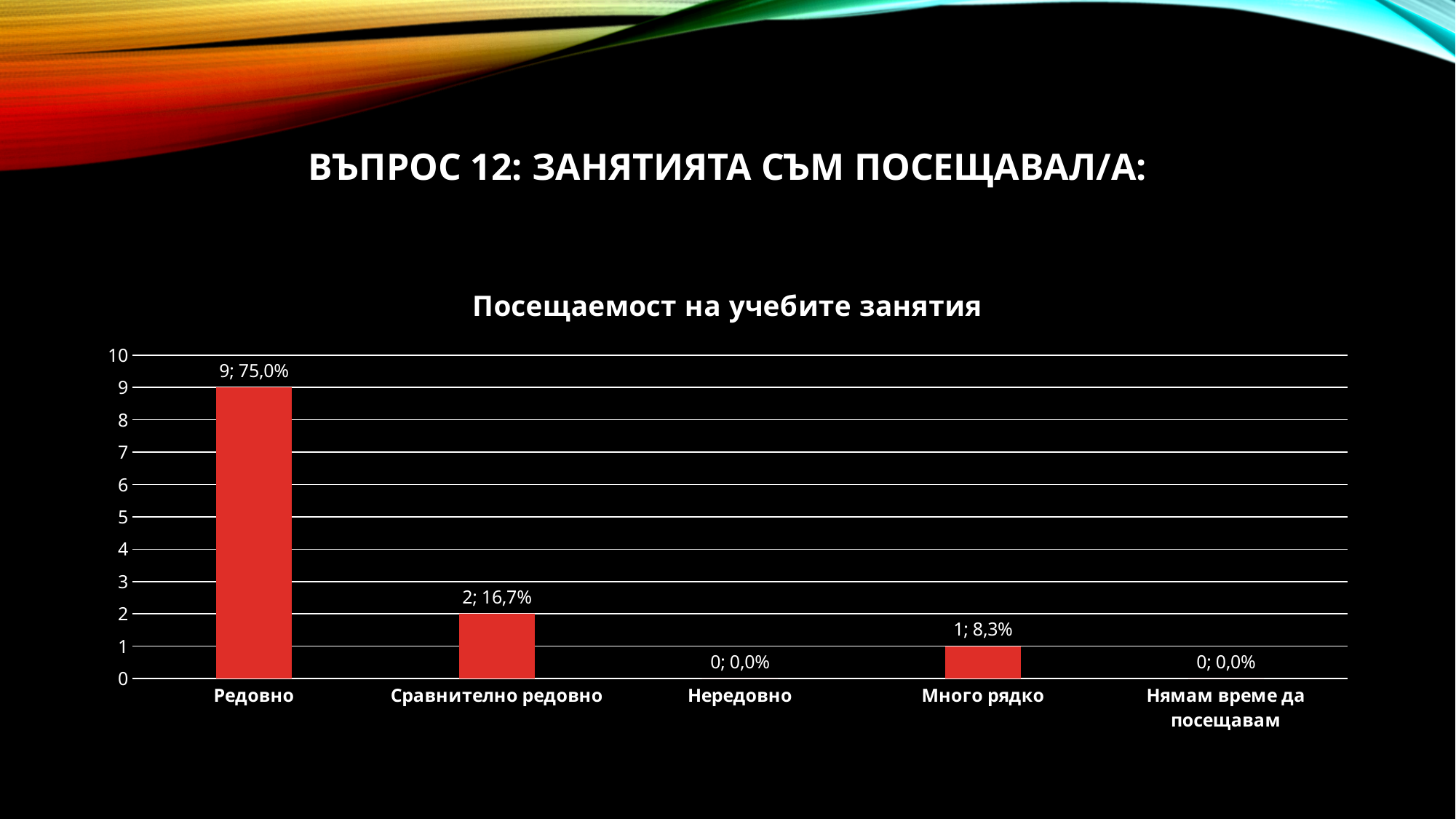
What is the value for Сравнително редовно? 2; 16,7% Which category has the highest value? Редовно What is the title of the chart? Посещаемост на учебите занятия Is the value for Редовно greater or less than 5? greater What colour are the bars in the chart? red What is the difference between the counts for Редовно and Сравнително редовно? 7 What is the value for Редовно? 9; 75,0% How many categories are shown on the x axis? 5 What is the value for Много рядко? 1; 8,3% Which is larger, the value for Сравнително редовно or the value for Много рядко? Сравнително редовно What kind of chart is shown? bar chart What is the value for Нередовно? 0; 0,0%